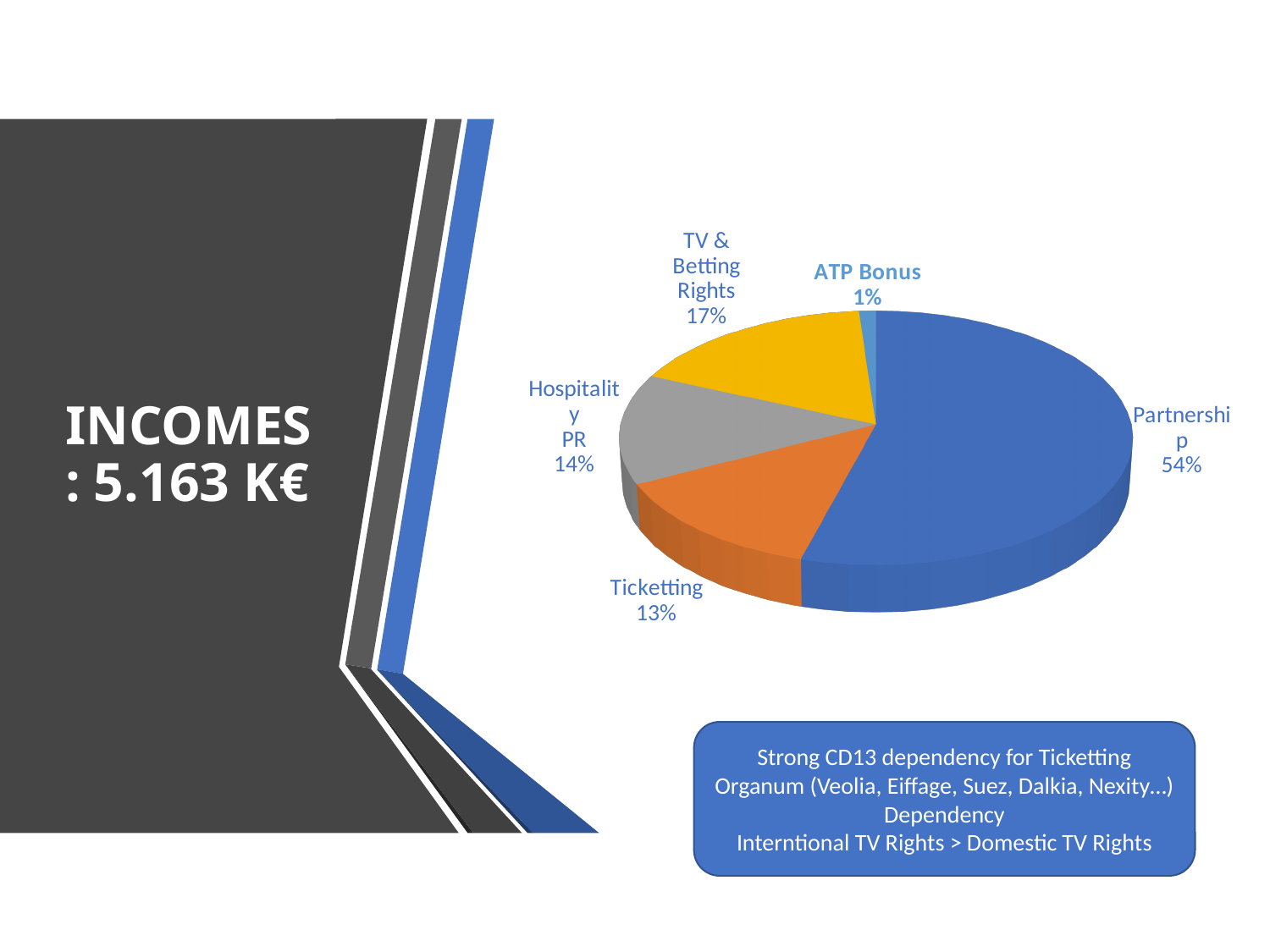
Which income category has the largest share of the pie? Partnership What share of incomes comes from ATP Bonus? 1% Which income category has the smallest share of the pie? ATP Bonus What share of incomes comes from TV & Betting Rights? 17% What share of incomes comes from Partnership? 54% What is the difference in percentage points between the Partnership share and the TV & Betting Rights share? 37 Which has a larger share, Hospitality PR or Ticketting? Hospitality PR What share of incomes comes from Hospitality PR? 14% How many categories are shown in the pie chart? 5 What kind of chart is shown on the slide? Pie chart What total income amount is stated in the slide title? 5.163 K€ What share of incomes comes from Ticketting? 13%